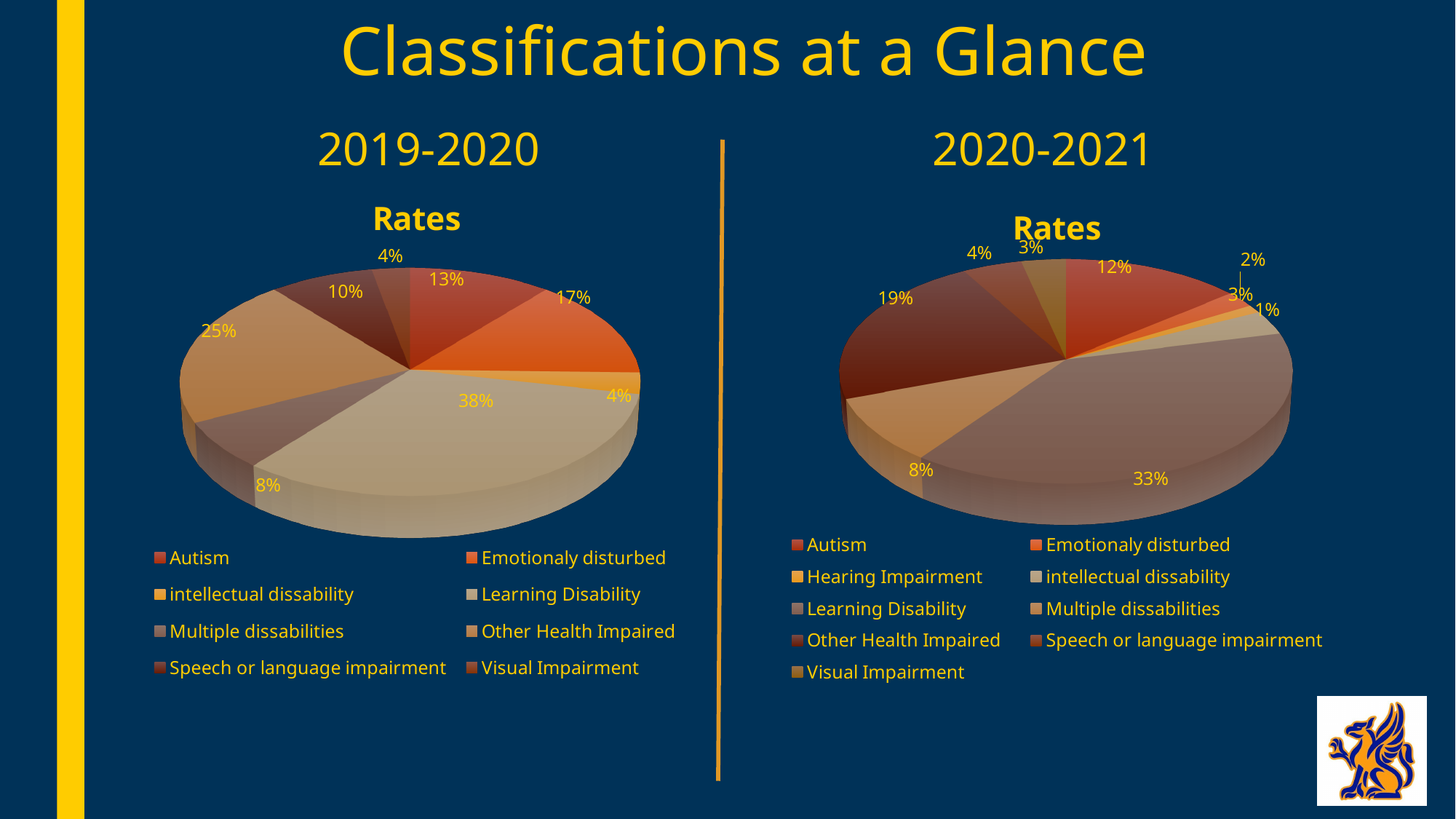
In the 2020-2021 pie chart, what percentage is shown for Autism? 12% In the 2019-2020 pie chart, what percentage is shown for Learning Disability? 38% In the 2019-2020 pie chart, what is the difference between the Learning Disability and Other Health Impaired percentages? 13% In the 2019-2020 pie chart, what percentage is shown for Other Health Impaired? 25% In the 2019-2020 pie chart, what percentage is shown for Emotionaly disturbed? 17% What type of chart is used for the 2019-2020 Rates? Pie chart In the 2020-2021 pie chart, what percentage is shown for Learning Disability? 33% In the 2020-2021 pie chart, which category has the smallest slice? Hearing Impairment In the 2020-2021 pie chart, what percentage is shown for Other Health Impaired? 19% In the 2020-2021 pie chart, which is larger, the Autism slice or the Multiple dissabilities slice? Autism In the 2019-2020 pie chart, which category has the largest slice? Learning Disability How many categories does the legend of the 2020-2021 pie chart list? 9